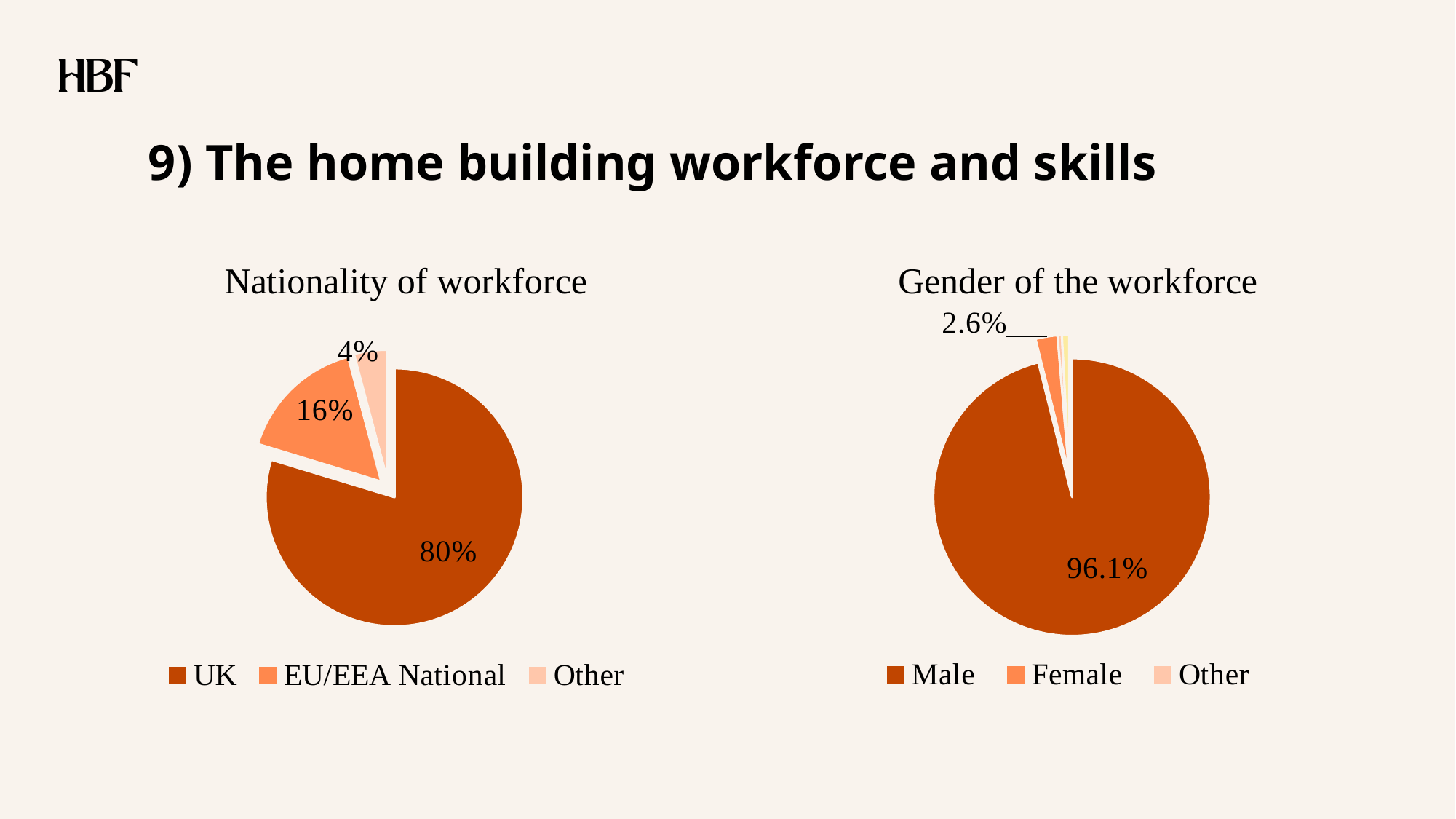
In the 'Nationality of workforce' chart, which category has the smallest slice? Other In the 'Gender of the workforce' chart, which is larger, the Male slice or the Female slice? Male In the 'Nationality of workforce' chart, what share of the workforce is UK? 80% How many categories does the legend of the 'Gender of the workforce' chart list? 3 In the 'Gender of the workforce' chart, which category has the largest slice? Male In the 'Nationality of workforce' chart, which category has the largest slice? UK What kind of chart is the 'Nationality of workforce' chart? Pie chart In the 'Gender of the workforce' chart, what share of the workforce is Female? 2.6% In the 'Gender of the workforce' chart, what share of the workforce is Male? 96.1% In the 'Nationality of workforce' chart, what is the difference in percentage points between the UK and EU/EEA National slices? 64 In the 'Nationality of workforce' chart, what share of the workforce is Other? 4% In the 'Nationality of workforce' chart, what share of the workforce is EU/EEA National? 16%